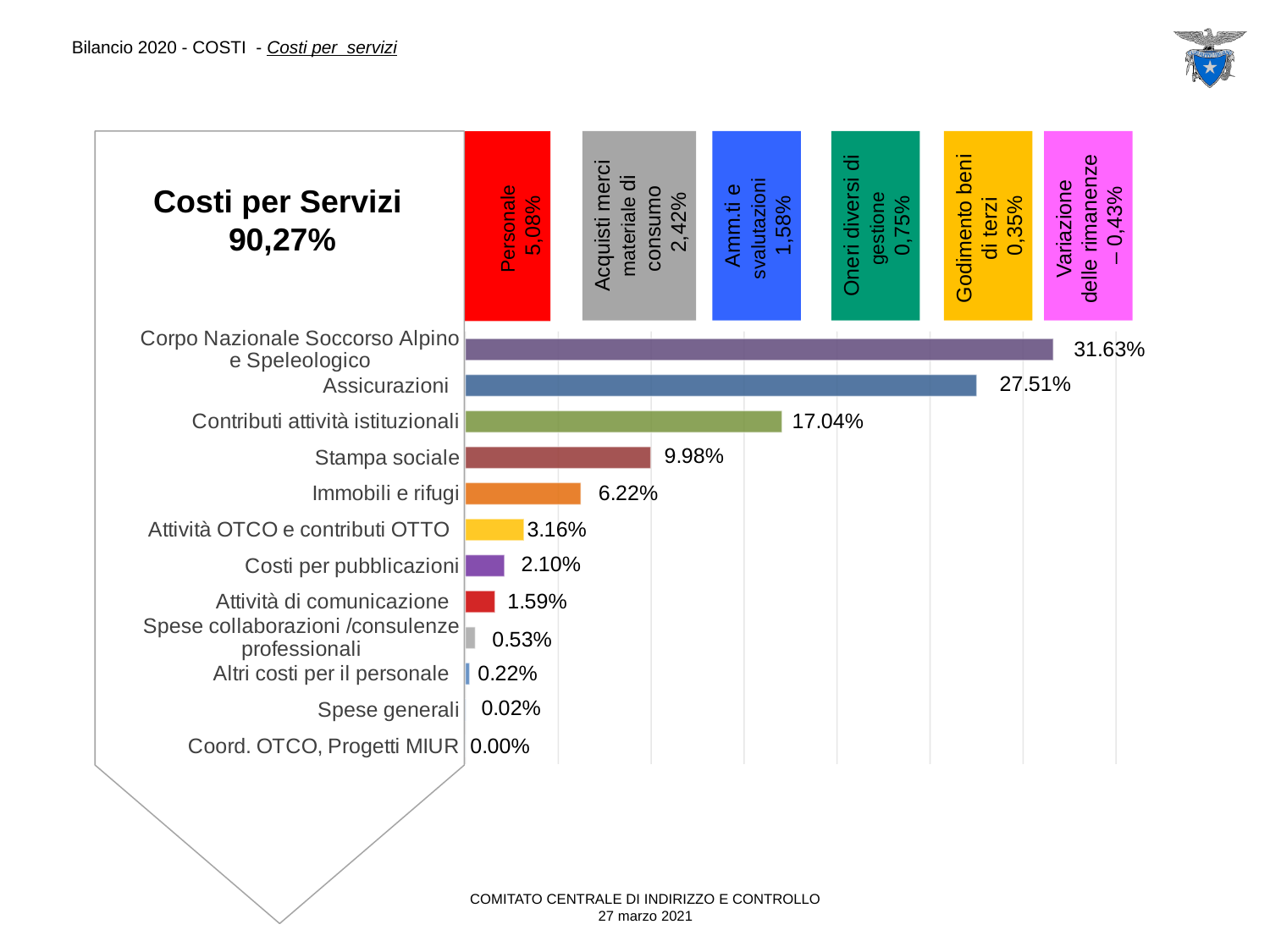
Which category has the highest value? Corpo Nazionale Soccorso Alpino e Speleologico Which category has the lowest value? Coord. OTCO, Progetti MIUR What is the value for Costi per pubblicazioni? 2.10% What is the value for Stampa sociale? 9.98% Which is larger, the value for Attività OTCO e contributi OTTO or the value for Attività di comunicazione? Attività OTCO e contributi OTTO How many categories are shown in the bar chart? 12 What kind of chart is shown on the slide? bar chart What is the value for Altri costi per il personale? 0.22% What is the value for Immobili e rifugi? 6.22% What is the value for Assicurazioni? 27.51% What is the difference between the values for Contributi attività istituzionali and Stampa sociale? 7.06% What is the difference between the values for Corpo Nazionale Soccorso Alpino e Speleologico and Assicurazioni? 4.12%